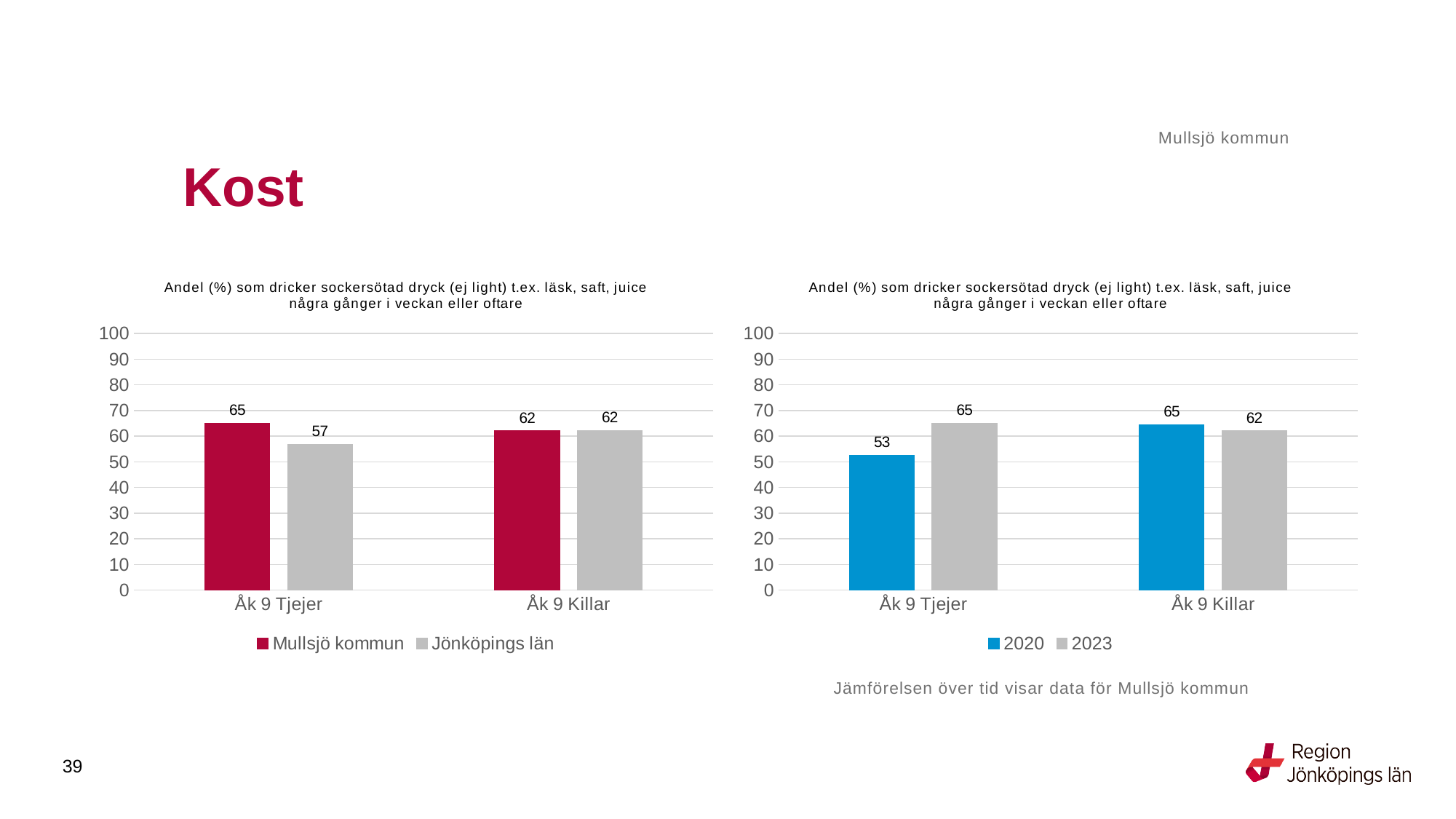
In the left chart, what is the value for Mullsjö kommun for Åk 9 Tjejer? 65 In the left chart, which is larger for Åk 9 Tjejer: Mullsjö kommun or Jönköpings län? Mullsjö kommun In the right chart, which category has the lowest value for 2020? Åk 9 Tjejer How many series does the legend of the right chart list? 2 In the right chart, what is the value for 2020 for Åk 9 Tjejer? 53 In the left chart, how many categories are shown on the x axis? 2 In the right chart, what is the difference between 2023 and 2020 for Åk 9 Tjejer? 12 In the left chart, what is the value for Jönköpings län for Åk 9 Killar? 62 In the left chart, what is the difference between Mullsjö kommun and Jönköpings län for Åk 9 Tjejer? 8 What kind of chart is the left chart? bar chart In the right chart, did the value for Åk 9 Tjejer rise or fall from 2020 to 2023? rise In the right chart, what is the value for 2023 for Åk 9 Killar? 62